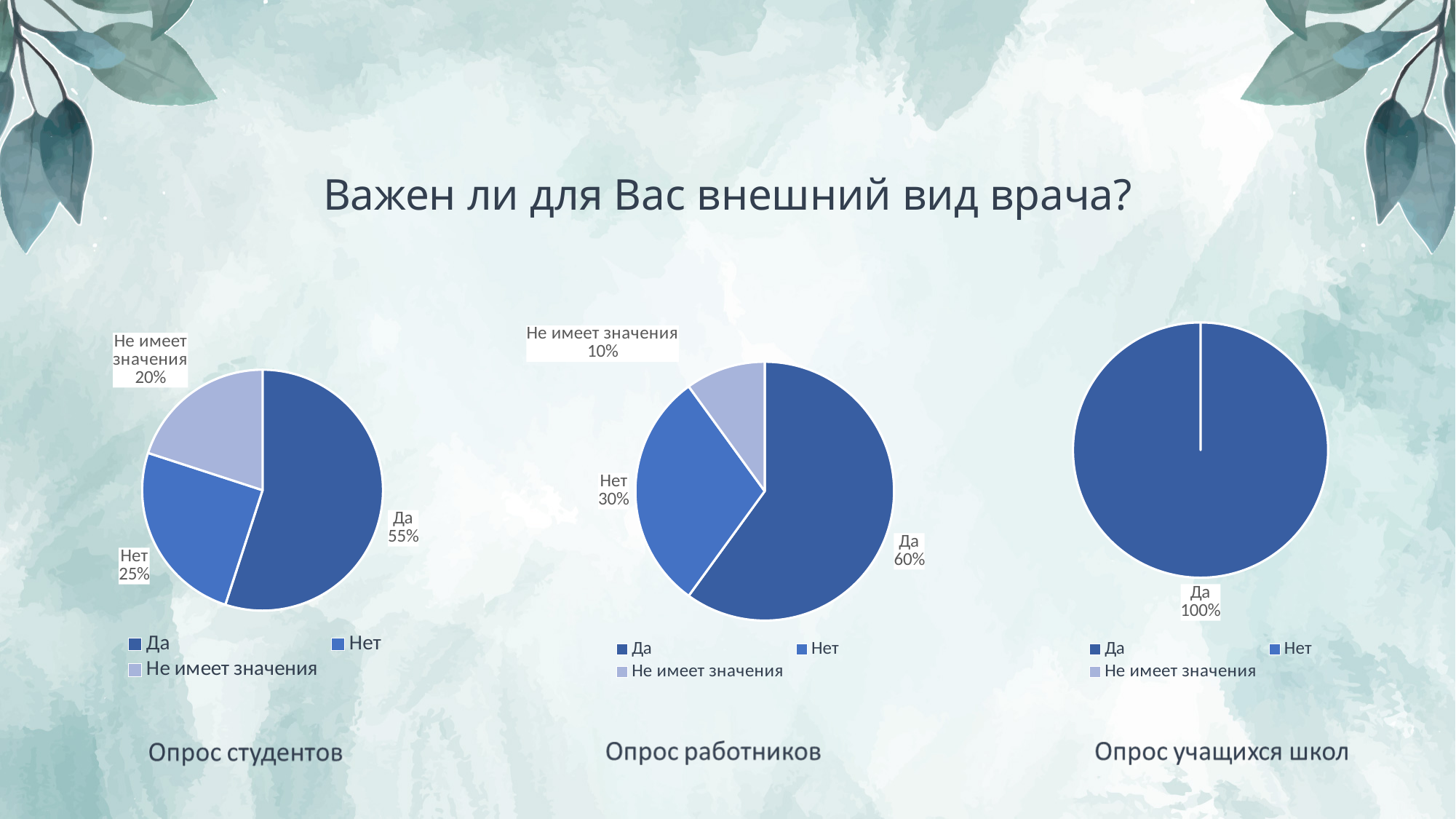
In the "Опрос работников" chart, what share of respondents answered "Не имеет значения"? 10% In the "Опрос учащихся школ" chart, what share of respondents answered "Да"? 100% How many slices are visible in the "Опрос учащихся школ" pie chart? 1 What kind of chart is used for "Опрос работников"? Pie chart In the "Опрос работников" chart, what is the difference between the "Да" and "Нет" shares? 30% How many entries does the legend of the "Опрос студентов" chart list? 3 In the "Опрос студентов" chart, what share of respondents answered "Нет"? 25% In the "Опрос студентов" chart, which is larger: the "Нет" share or the "Не имеет значения" share? Нет What is the title of the slide above the three pie charts? Важен ли для Вас внешний вид врача? In the "Опрос студентов" chart, what share of respondents answered "Да"? 55% In the "Опрос работников" chart, which answer has the largest slice? Да In the "Опрос студентов" chart, which answer has the smallest slice? Не имеет значения